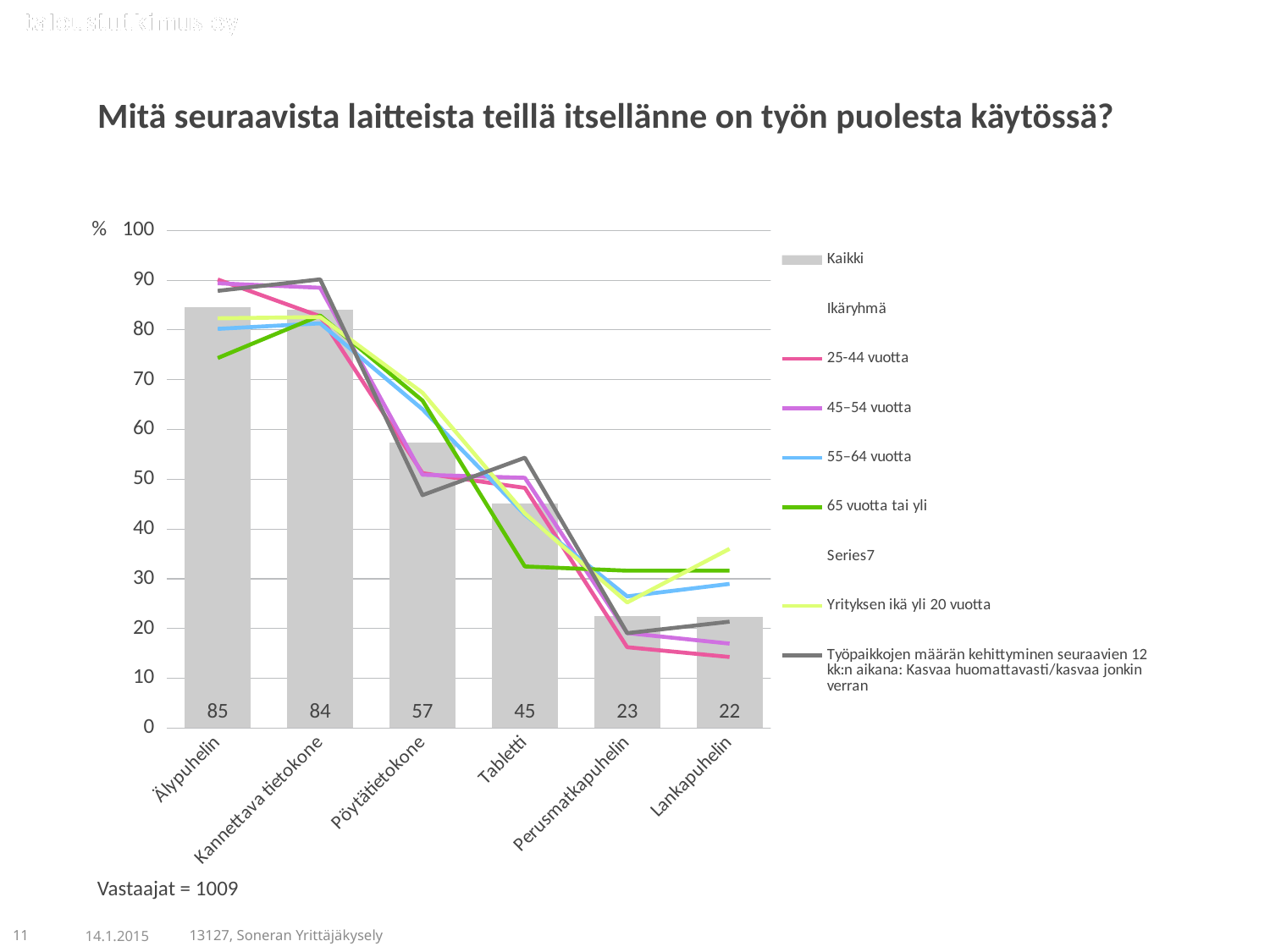
Is the value of the 25-44 vuotta line for Älypuhelin greater or less than 80? greater What is the difference between the Kaikki values for Pöytätietokone and Tabletti? 12 What is the title of the chart? Mitä seuraavista laitteista teillä itsellänne on työn puolesta käytössä? Do the Kaikki bar values rise or fall from left to right along the x axis? fall Which category has the lowest Kaikki bar? Lankapuhelin How many device categories are shown on the x axis? 6 What is the value of the Kaikki bar for Tabletti? 45 Is the value of the 65 vuotta tai yli line for Älypuhelin greater or less than 80? less Which has a larger Kaikki value, Kannettava tietokone or Pöytätietokone? Kannettava tietokone Which category has the highest Kaikki bar? Älypuhelin What is the difference between the Kaikki values for Älypuhelin and Lankapuhelin? 63 What is the value of the Kaikki bar for Älypuhelin? 85